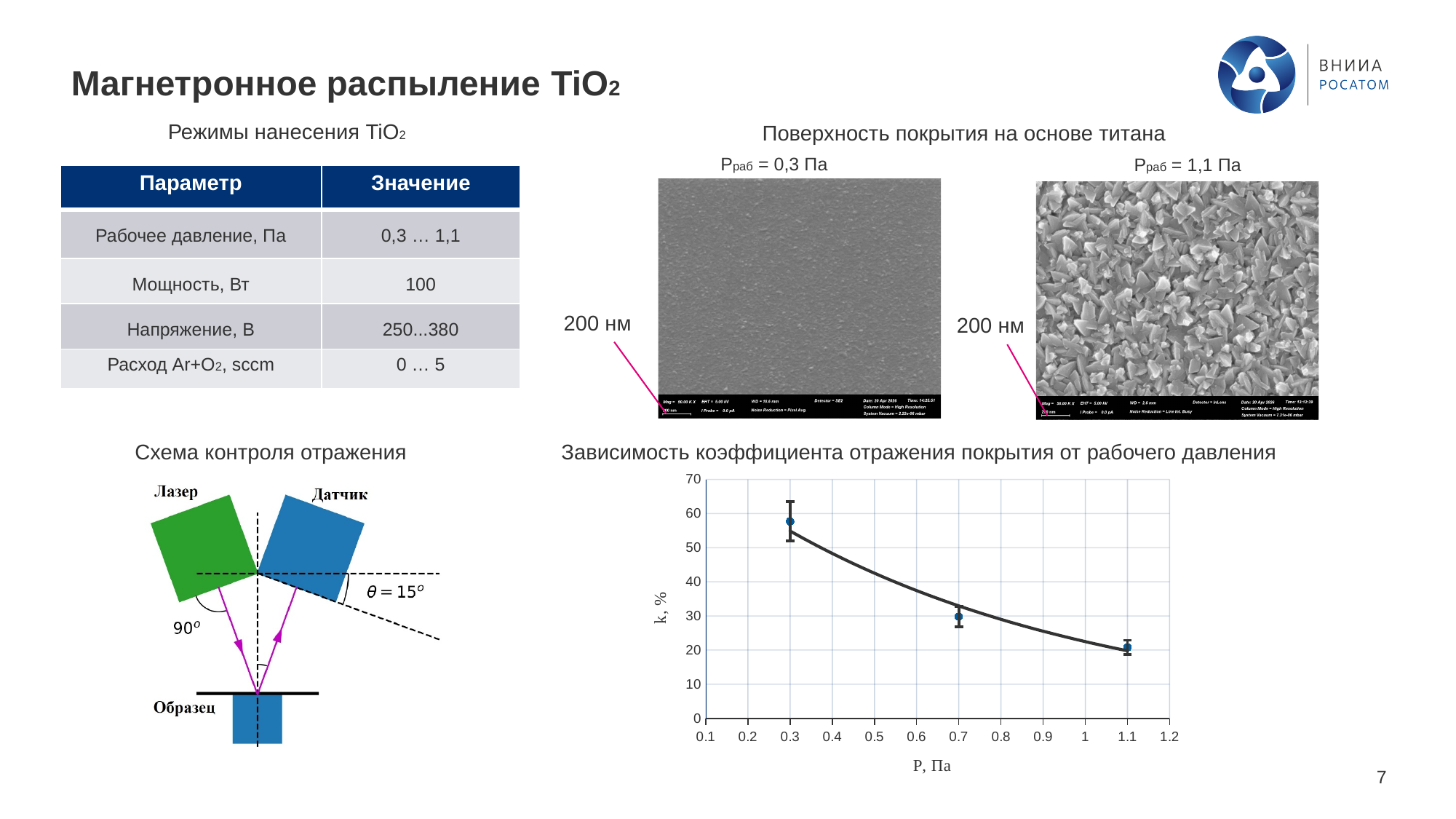
What is the label of the y axis of the chart? k, % Is the value of k at P = 0.3 greater or less than 50? greater Is the value of k at P = 1.1 greater or less than 10? greater At which pressure P is the reflection coefficient k highest? 0.3 Is the value of k at P = 1.1 greater or less than 30? less What kind of chart is shown at the bottom right of the slide? line chart At which pressure P is the reflection coefficient k lowest? 1.1 Does the reflection coefficient k rise or fall as the pressure P increases along the x axis? fall How many data points are plotted on the chart? 3 Which has a larger value of k: P = 0.3 or P = 1.1? P = 0.3 What is the title of the chart on the slide? Зависимость коэффициента отражения покрытия от рабочего давления